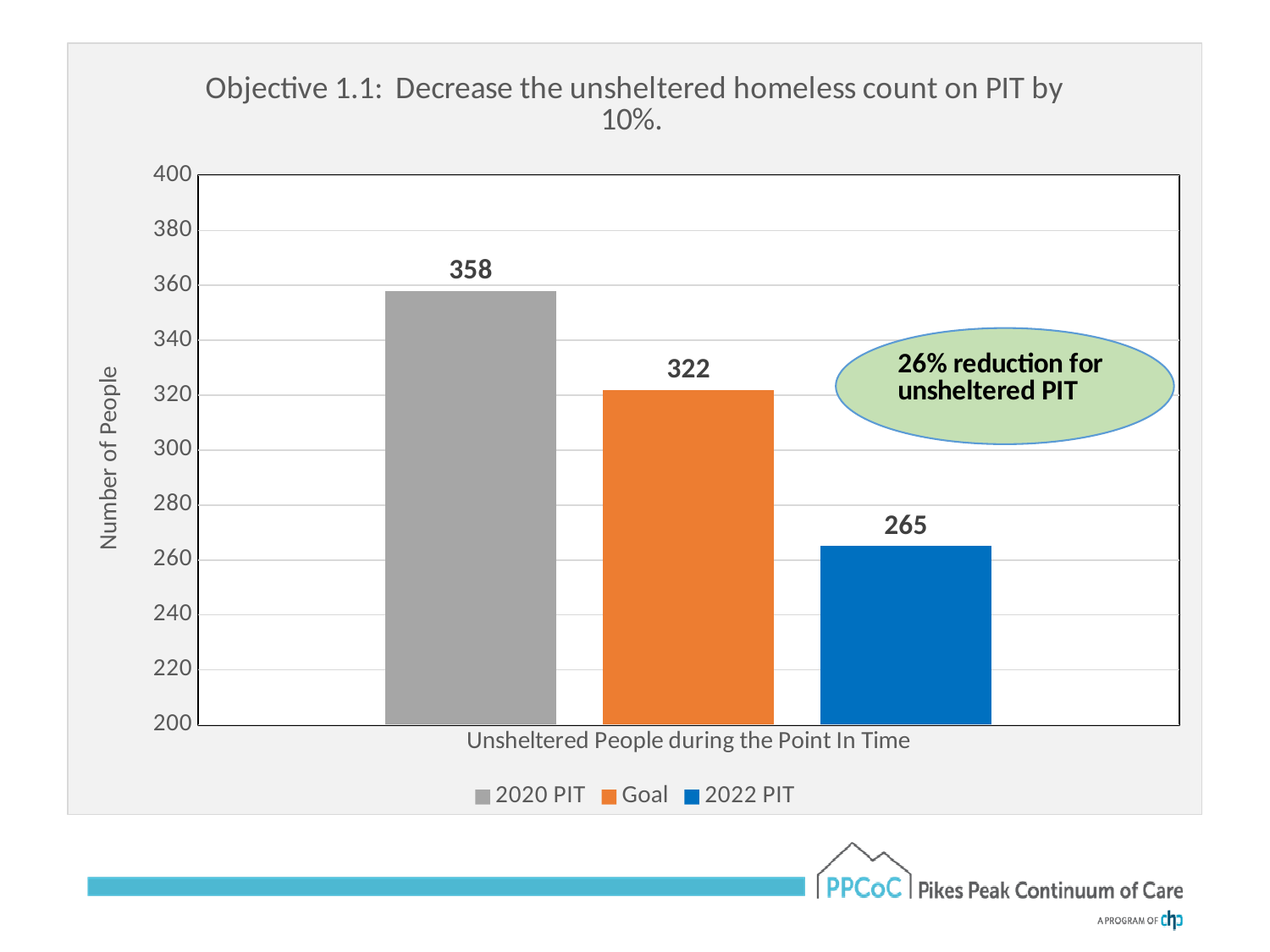
What is the value for 2020 PIT? 358 How many series does the legend list? 3 What is the value for Goal? 322 What is the difference between the Goal value and the 2022 PIT value? 57 Which series has the lowest value? 2022 PIT What is the difference between the 2020 PIT value and the 2022 PIT value? 93 Which series has the highest value? 2020 PIT What kind of chart is shown on the slide? bar chart What is the label on the vertical axis? Number of People Is the value for 2022 PIT greater or less than 280? less Which is larger, the Goal value or the 2022 PIT value? Goal What is the value for 2022 PIT? 265